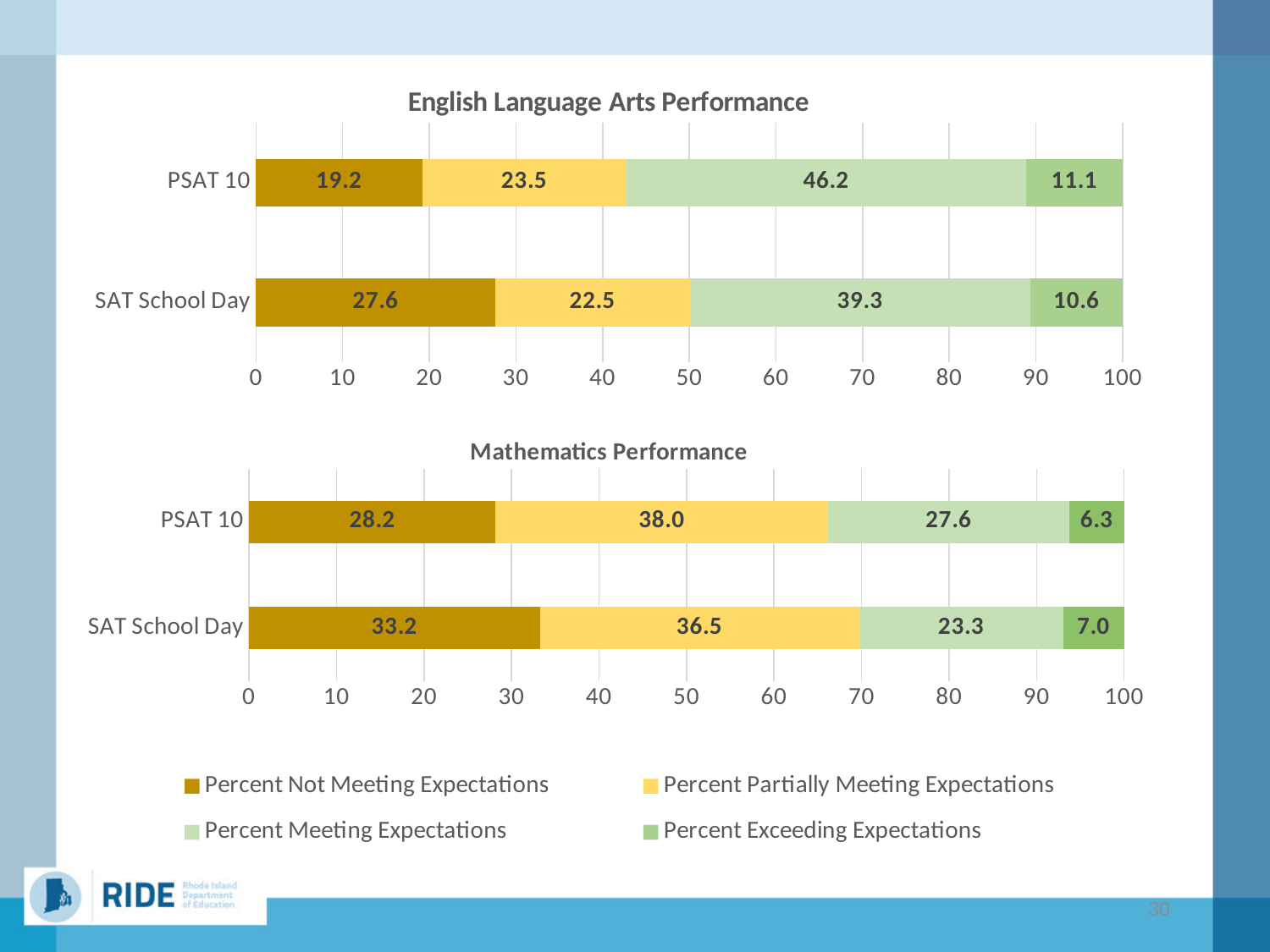
How many series does the legend list? 4 In the Mathematics Performance chart, what is the Percent Partially Meeting Expectations value for SAT School Day? 36.5 In the English Language Arts Performance chart, what is the Percent Not Meeting Expectations value for SAT School Day? 27.6 In the Mathematics Performance chart, which has the larger Percent Meeting Expectations value, PSAT 10 or SAT School Day? PSAT 10 In the Mathematics Performance chart, which segment of the SAT School Day bar is the smallest? Percent Exceeding Expectations What kind of chart is the Mathematics Performance chart? Stacked bar chart In the English Language Arts Performance chart, what is the Percent Meeting Expectations value for PSAT 10? 46.2 In the English Language Arts Performance chart, which segment of the PSAT 10 bar is the largest? Percent Meeting Expectations In the English Language Arts Performance chart, what is the difference between the Percent Not Meeting Expectations values for SAT School Day and PSAT 10? 8.4 In the Mathematics Performance chart, what is the total of the SAT School Day bar? 100.0 How many categories are shown in the English Language Arts Performance chart? 2 In the Mathematics Performance chart, what is the Percent Exceeding Expectations value for PSAT 10? 6.3